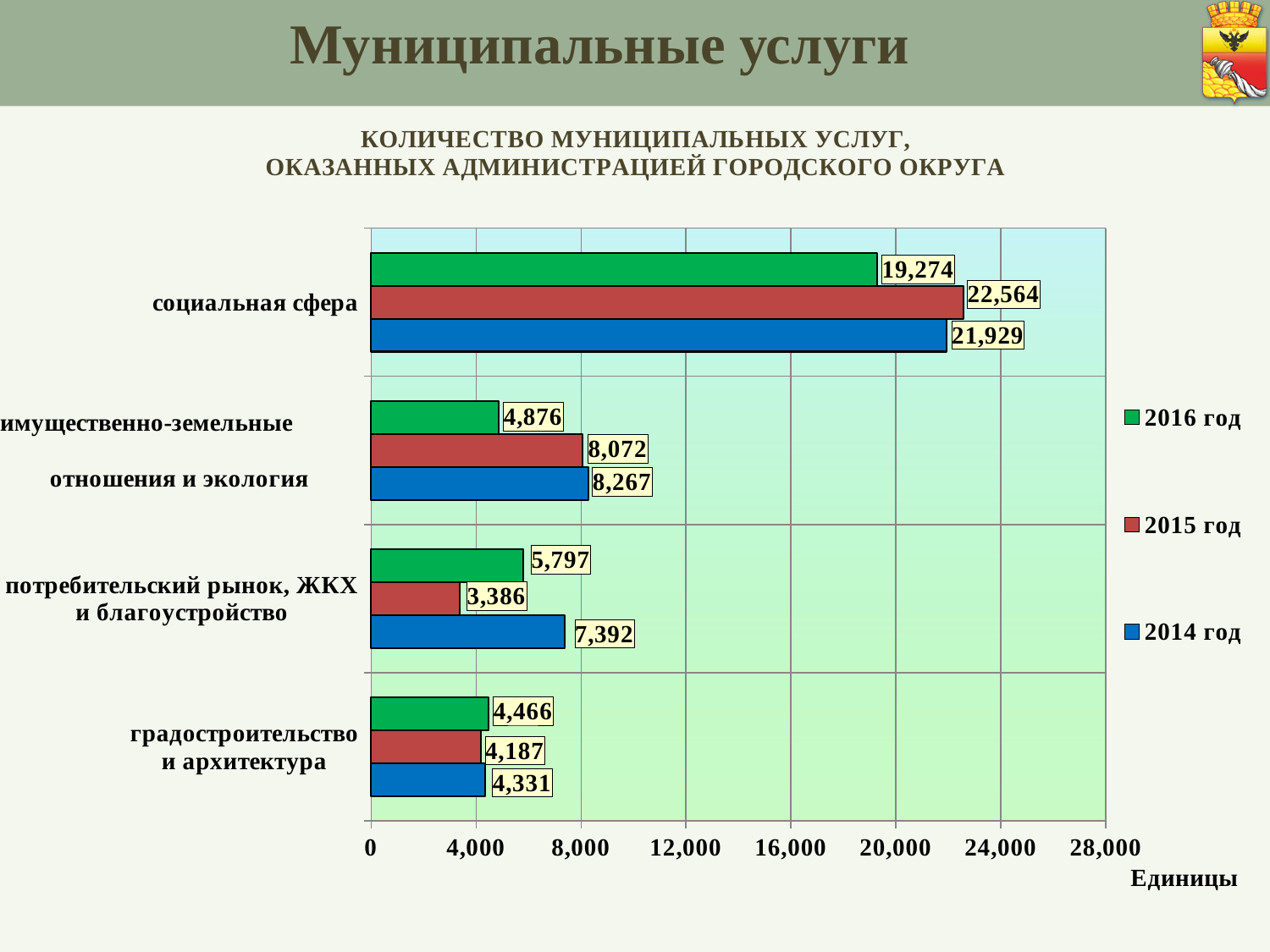
Is the 2014 год value for социальная сфера greater or less than 20,000? greater What is the difference between the 2015 год and 2016 год values for социальная сфера? 3,290 What is the value for социальная сфера in 2015 год? 22,564 What is the value for градостроительство и архитектура in 2016 год? 4,466 Which is larger for имущественно-земельные отношения и экология: the 2014 год value or the 2016 год value? 2014 год Which category has the lowest value in 2015 год? потребительский рынок, ЖКХ и благоустройство What type of chart is shown on the slide? bar chart What is the value for потребительский рынок, ЖКХ и благоустройство in 2014 год? 7,392 How many series does the legend list? 3 What unit label is shown below the x axis? Единицы Which category has the highest value in 2016 год? социальная сфера How many categories are shown on the chart? 4